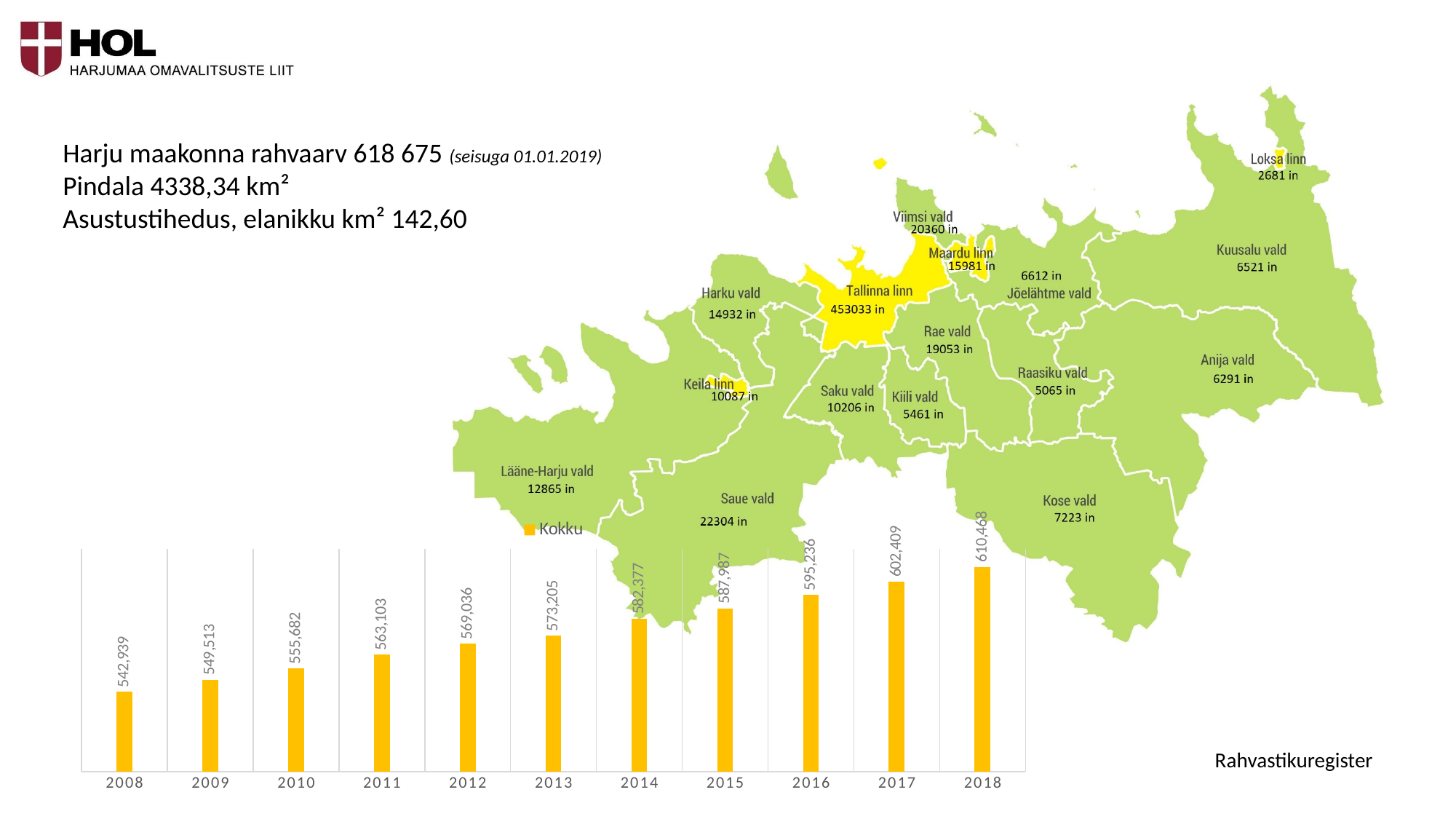
Which is larger in the bar chart, the value for 2011 or the value for 2015? 2015 What kind of chart is shown at the bottom of the slide? bar chart What is the value for 2018 in the bar chart? 610,468 Which year has the highest value in the bar chart? 2018 What is the value for 2013 in the bar chart? 573,205 Do the values in the bar chart rise or fall from 2008 to 2018? rise What is the difference between the values for 2018 and 2008 in the bar chart? 67,529 Which year has the lowest value in the bar chart? 2008 What is the value for 2008 in the bar chart? 542,939 What is the difference between the values for 2017 and 2016 in the bar chart? 7,173 How many series does the legend of the bar chart list? 1 How many years are shown on the x axis of the bar chart? 11